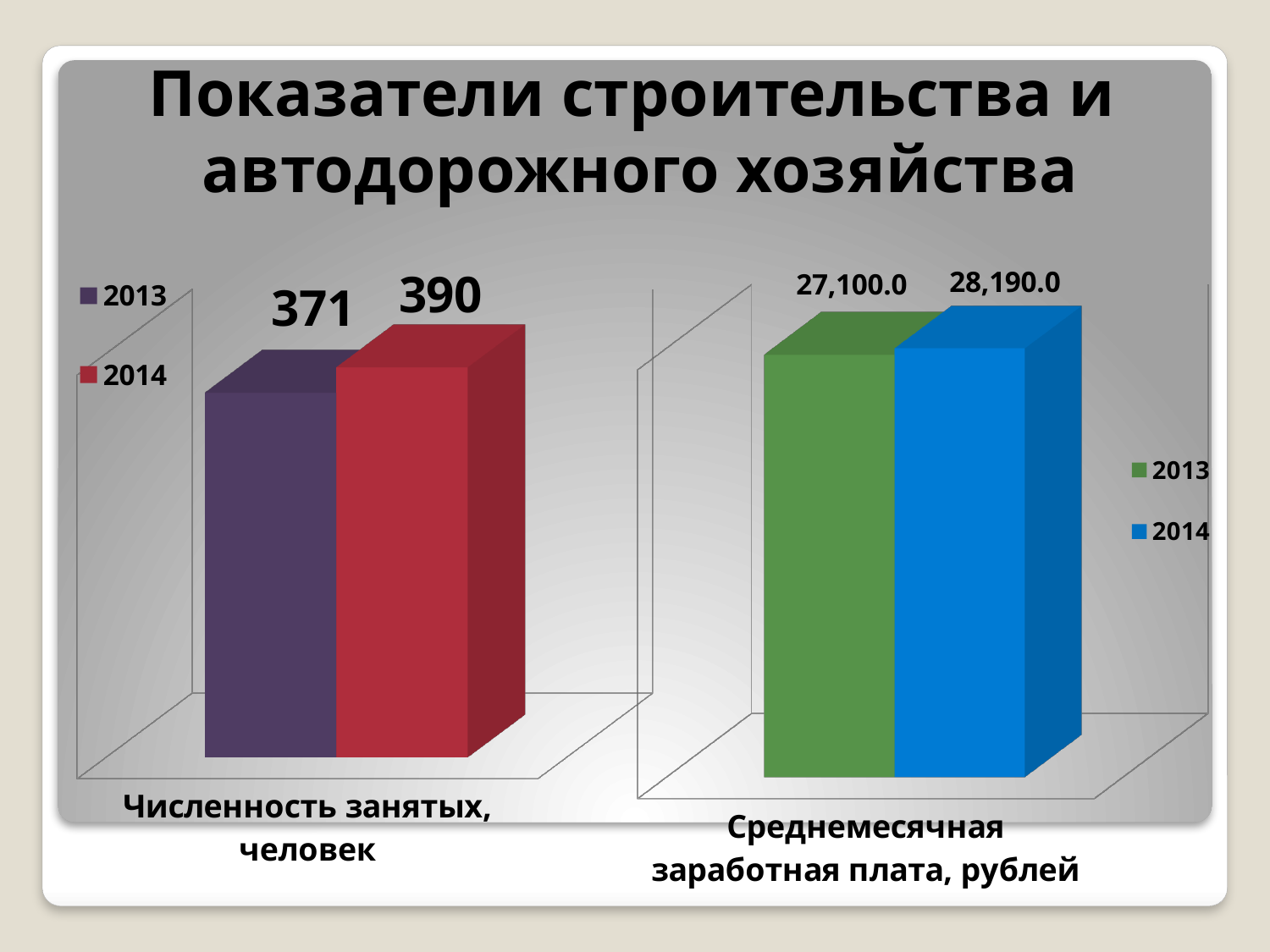
What is the title of the slide? Показатели строительства и автодорожного хозяйства In the left chart (Численность занятых, человек), what is the value for 2013? 371 In the right chart (Среднемесячная заработная плата, рублей), which year has the lower value? 2013 What kind of chart is the right chart (Среднемесячная заработная плата, рублей)? bar chart In the left chart (Численность занятых, человек), what is the difference between the 2014 and 2013 values? 19 In the right chart (Среднемесячная заработная плата, рублей), what is the value for 2014? 28,190.0 In the left chart (Численность занятых, человек), which year has the higher value? 2014 In the left chart (Численность занятых, человек), what is the value for 2014? 390 How many series does the legend of the left chart list? 2 In the right chart (Среднемесячная заработная плата, рублей), by how much does the 2014 value exceed the 2013 value? 1,090.0 In the right chart (Среднемесячная заработная плата, рублей), what is the value for 2013? 27,100.0 In the right chart (Среднемесячная заработная плата, рублей), is the value for 2014 larger or smaller than the value for 2013? larger